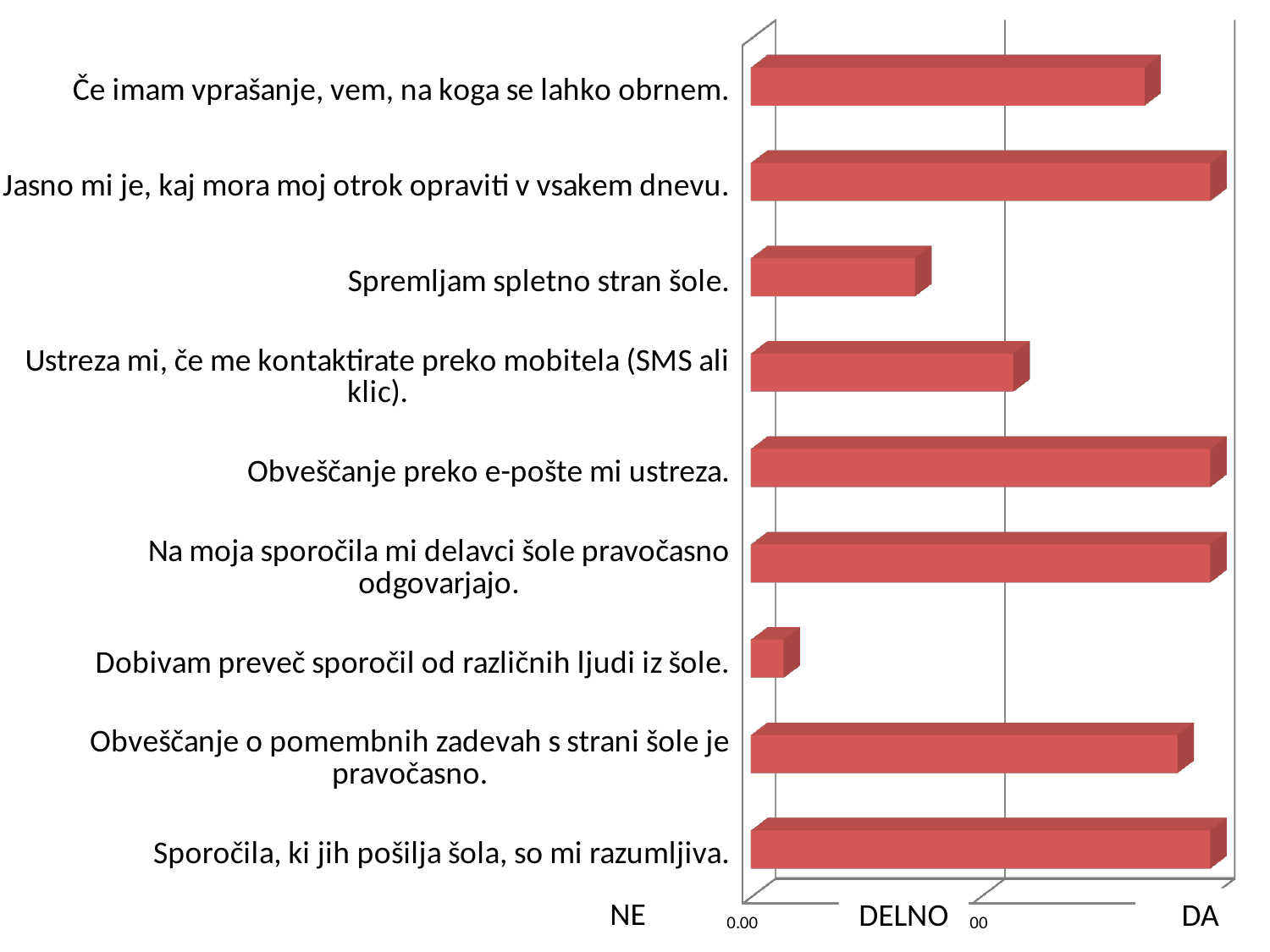
Which has the larger value: "Če imam vprašanje, vem, na koga se lahko obrnem." or "Spremljam spletno stran šole."? Če imam vprašanje, vem, na koga se lahko obrnem. Which has the larger value: "Spremljam spletno stran šole." or "Dobivam preveč sporočil od različnih ljudi iz šole."? Spremljam spletno stran šole. Which has the larger value: "Jasno mi je, kaj mora moj otrok opraviti v vsakem dnevu." or "Spremljam spletno stran šole."? Jasno mi je, kaj mora moj otrok opraviti v vsakem dnevu. What are the three labels shown along the horizontal axis of the chart? NE, DELNO, DA Is the value for "Dobivam preveč sporočil od različnih ljudi iz šole." greater or less than the DELNO mark on the axis? less What kind of chart is shown on the slide? bar chart What colour are the bars in the chart? red Is the value for "Spremljam spletno stran šole." greater or less than the DELNO mark on the axis? less How many categories (statements) are plotted in the chart? 9 Which statement has the lowest value in the chart? Dobivam preveč sporočil od različnih ljudi iz šole. Is the value for "Če imam vprašanje, vem, na koga se lahko obrnem." greater or less than the DELNO mark on the axis? greater